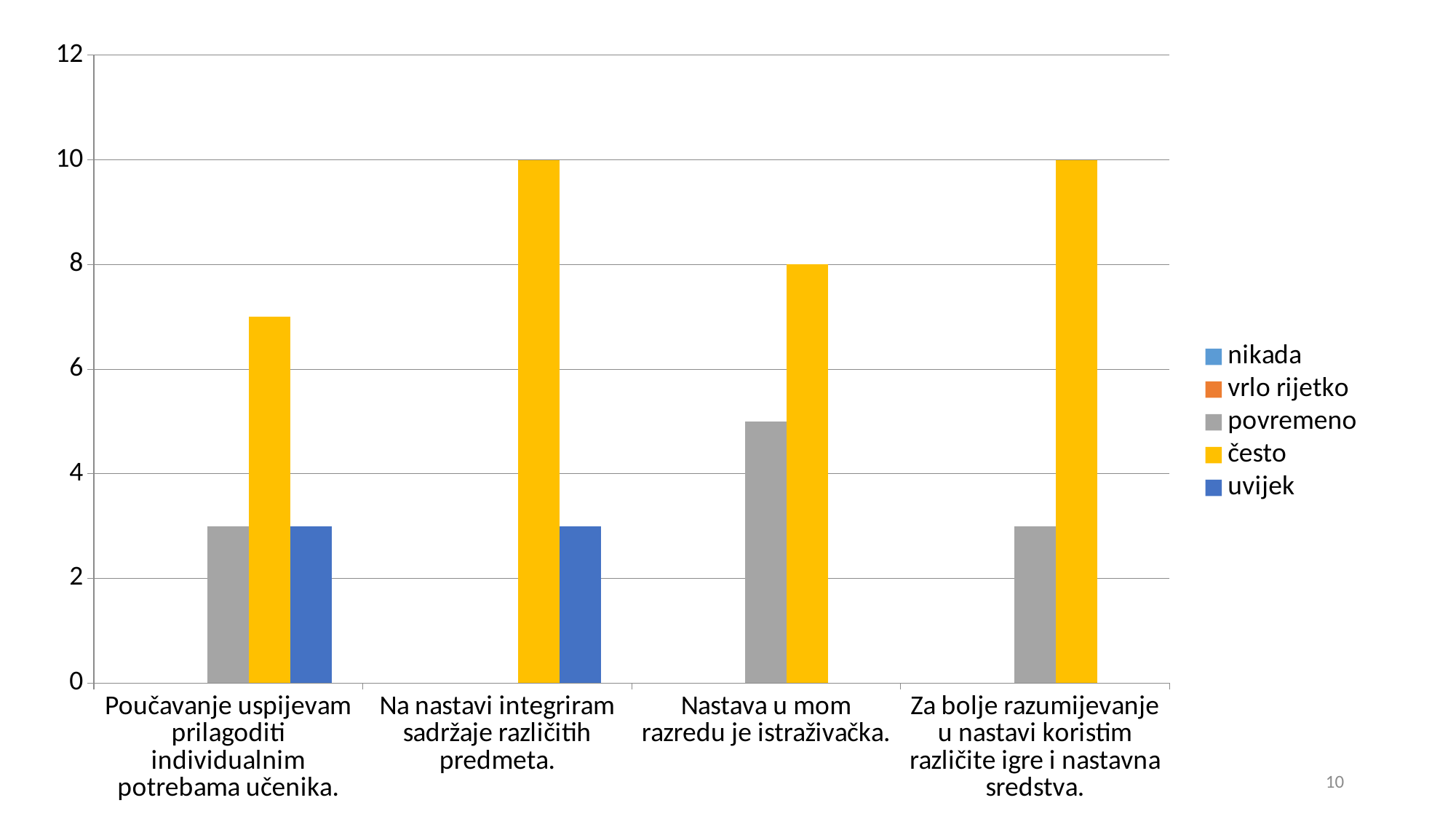
How many categories are shown on the x axis? 4 What kind of chart is shown on the slide? bar chart Which is larger for "Nastava u mom razredu je istraživačka.": "povremeno" or "često"? često What is the value of "često" for "Za bolje razumijevanje u nastavi koristim različite igre i nastavna sredstva."? 10 Which category has the lowest "često" value? Poučavanje uspijevam prilagoditi individualnim potrebama učenika. How many series does the legend list? 5 What is the value of "često" for "Na nastavi integriram sadržaje različitih predmeta."? 10 Is the value of "često" for "Poučavanje uspijevam prilagoditi individualnim potrebama učenika." greater or less than 6? greater What is the value of "često" for "Nastava u mom razredu je istraživačka."? 8 Which legend entry is shown in yellow? često Is the value of "uvijek" for "Na nastavi integriram sadržaje različitih predmeta." greater or less than 4? less Is the value of "povremeno" for "Nastava u mom razredu je istraživačka." greater or less than 4? greater